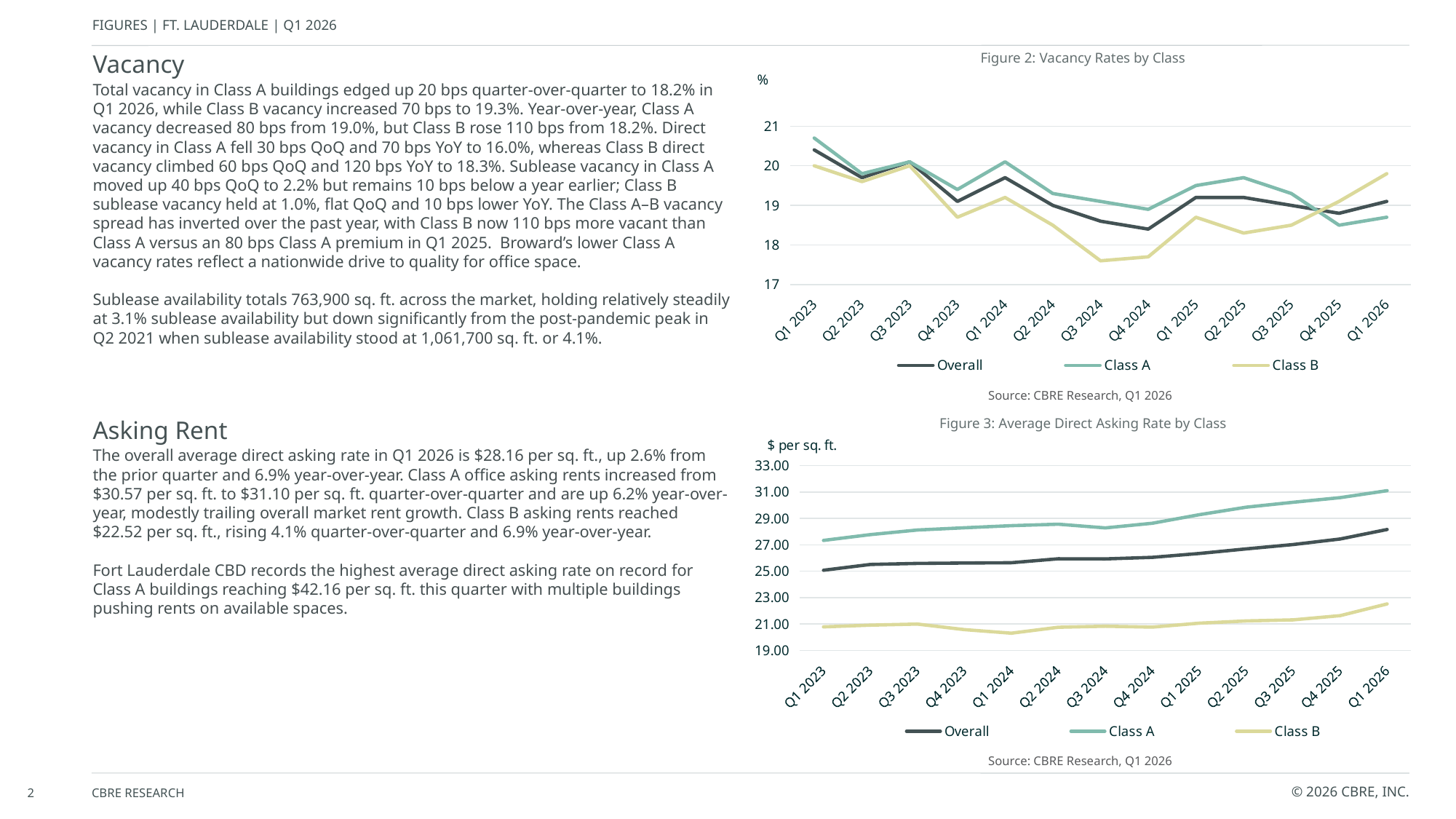
In Figure 3: Average Direct Asking Rate by Class, is the Class B value for Q1 2024 greater or less than 21.00? less In Figure 2: Vacancy Rates by Class, is the Class B value for Q3 2024 greater or less than 18? less In Figure 3: Average Direct Asking Rate by Class, is the Overall value for Q1 2026 greater or less than 27.00? greater What unit is shown on the y axis of Figure 3: Average Direct Asking Rate by Class? $ per sq. ft. How many series does the legend of Figure 3: Average Direct Asking Rate by Class list? 3 In Figure 3: Average Direct Asking Rate by Class, does the Class A line generally rise or fall from Q1 2023 to Q1 2026? Rise In Figure 3: Average Direct Asking Rate by Class, which series has the highest values across all quarters? Class A What kind of chart is Figure 2: Vacancy Rates by Class? Line chart In Figure 2: Vacancy Rates by Class, which is higher in Q3 2024, Class A or Class B? Class A How many quarters are plotted along the x axis of Figure 2: Vacancy Rates by Class? 13